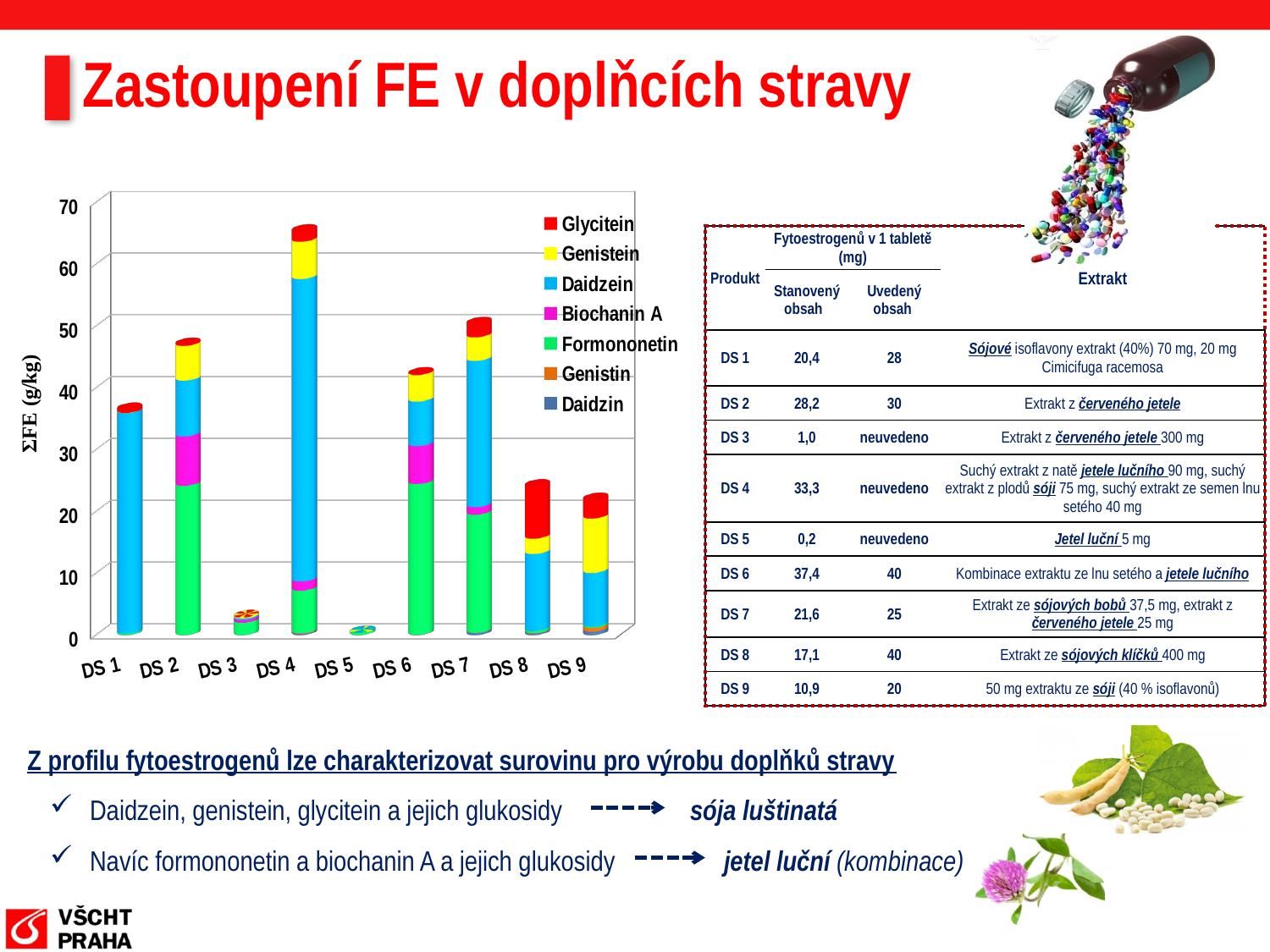
Which product has the lowest total ΣFE in the bar chart? DS 5 Which product has the highest total ΣFE in the bar chart? DS 4 Is the total ΣFE value for DS 2 greater or less than 40? greater Which has the larger total ΣFE, DS 2 or DS 1? DS 2 What is the label of the y axis of the bar chart? ΣFE (g/kg) Is the total ΣFE value for DS 3 greater or less than 10? less Is the total ΣFE value for DS 4 greater or less than 60? greater Which has the larger total ΣFE, DS 8 or DS 3? DS 8 How many series does the legend of the bar chart list? 7 What kind of chart is shown on the left of the slide? stacked bar chart How many products (categories) are plotted along the x axis of the bar chart? 9